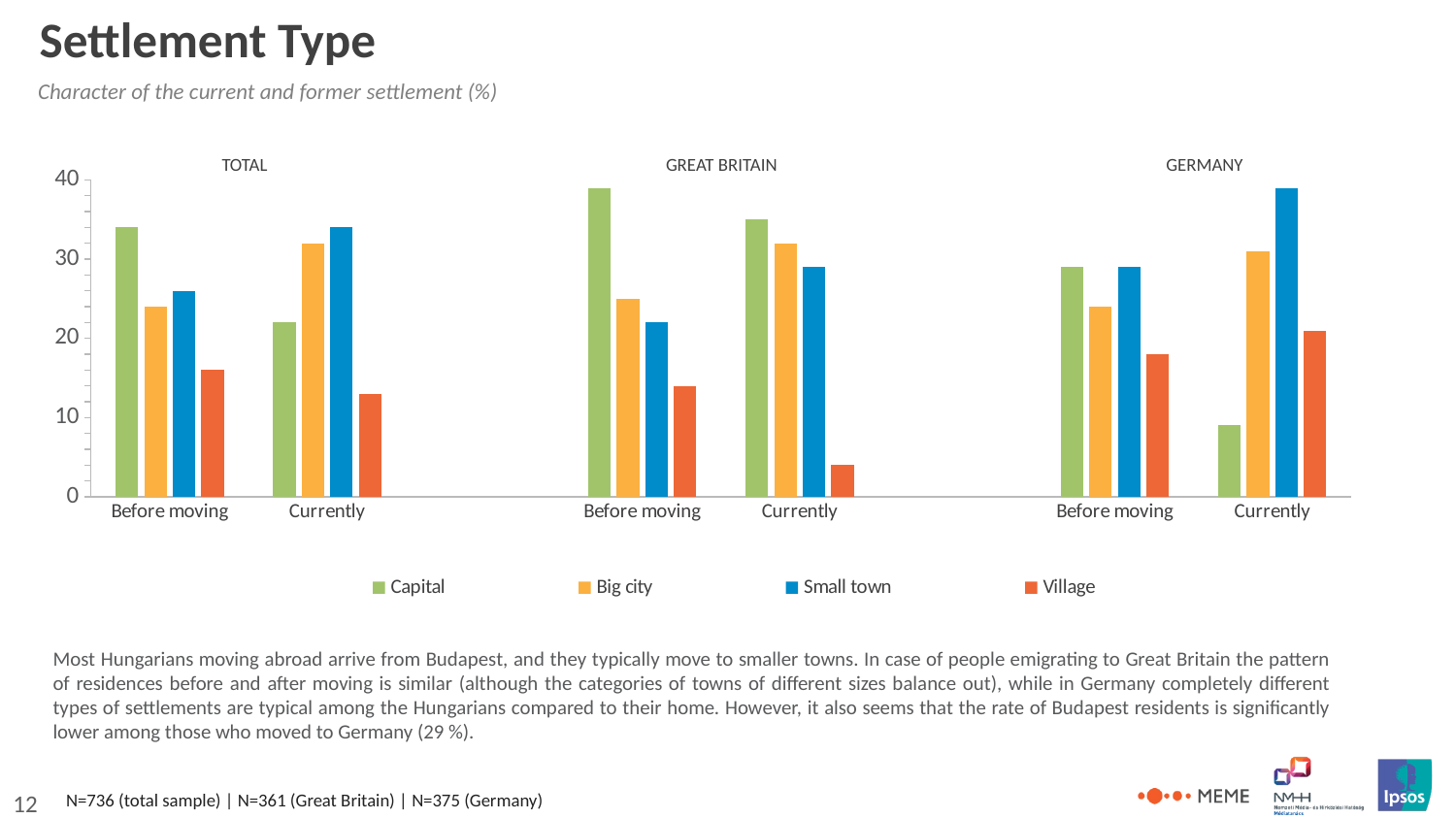
What are the four series listed in the legend? Capital, Big city, Small town, Village In the GERMANY panel, which series has the highest bar for Currently? Small town How many series does the legend list? 4 In the GREAT BRITAIN panel, which series has the lowest bar for Currently? Village What kind of chart is shown on the slide? bar chart In the GERMANY panel, is the value for Capital Currently greater or less than 20? less In the TOTAL panel, which series has the highest bar for Before moving? Capital In the TOTAL panel, for Before moving, which is larger: Capital or Village? Capital How many panels (groups) does the chart have, as labelled above the bars? 3 In the GREAT BRITAIN panel, is the value for Capital Before moving greater or less than 30? greater In the GREAT BRITAIN panel, is the value for Village Currently greater or less than 10? less In the GERMANY panel, for Currently, which is larger: Big city or Village? Big city